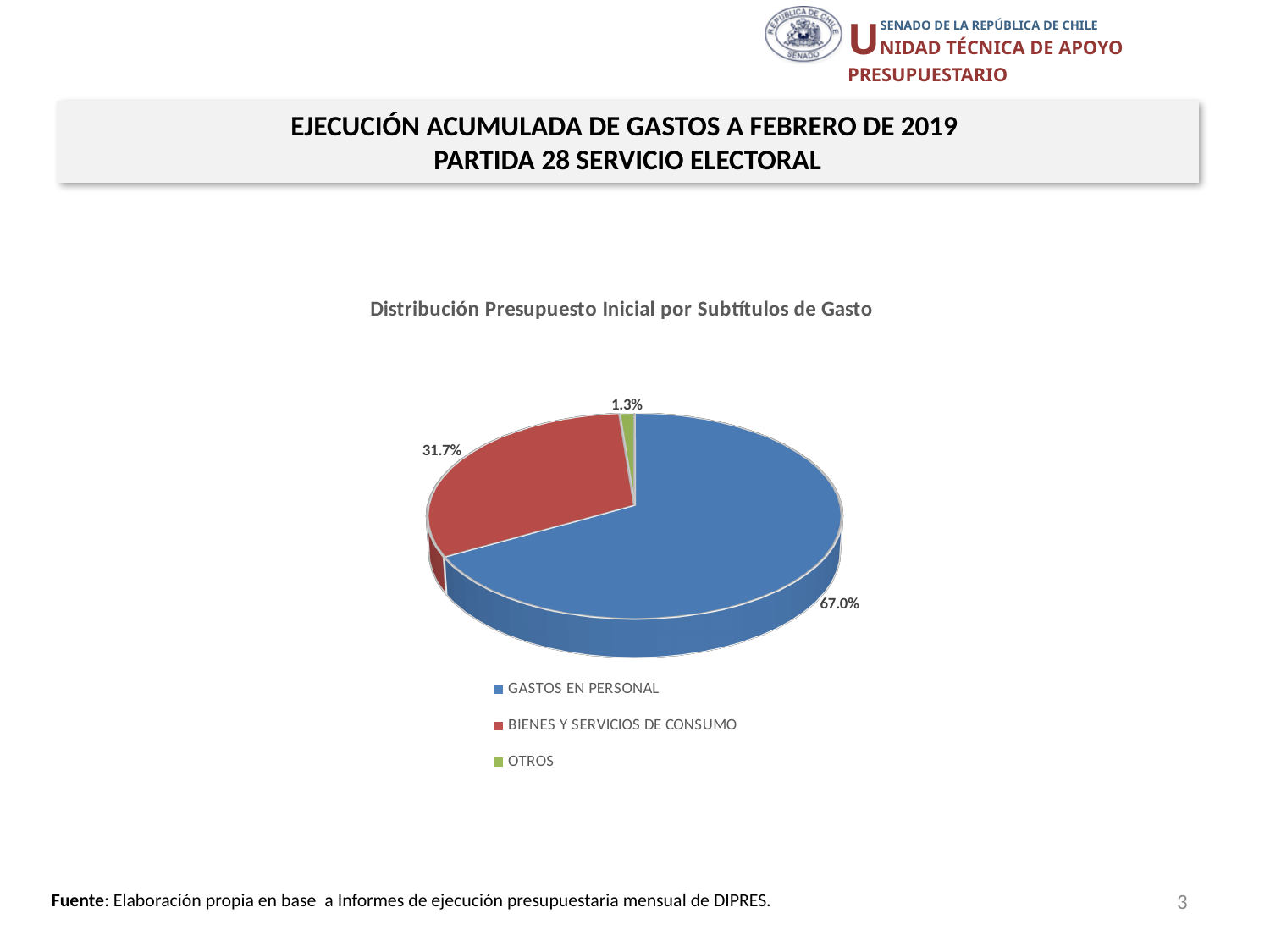
Which category has the largest share of the pie? GASTOS EN PERSONAL How many categories does the legend list? 3 What share of the pie does GASTOS EN PERSONAL represent? 67.0% What colour is the slice for OTROS? Green Which category has the smallest share of the pie? OTROS What is the difference in percentage points between GASTOS EN PERSONAL and BIENES Y SERVICIOS DE CONSUMO? 35.3 percentage points What is the title of the chart? Distribución Presupuesto Inicial por Subtítulos de Gasto What is the combined share of BIENES Y SERVICIOS DE CONSUMO and OTROS? 33.0% What type of chart is shown on the slide? Pie chart Which is larger, the share for BIENES Y SERVICIOS DE CONSUMO or the share for OTROS? BIENES Y SERVICIOS DE CONSUMO What share of the pie does BIENES Y SERVICIOS DE CONSUMO represent? 31.7% What share of the pie does OTROS represent? 1.3%